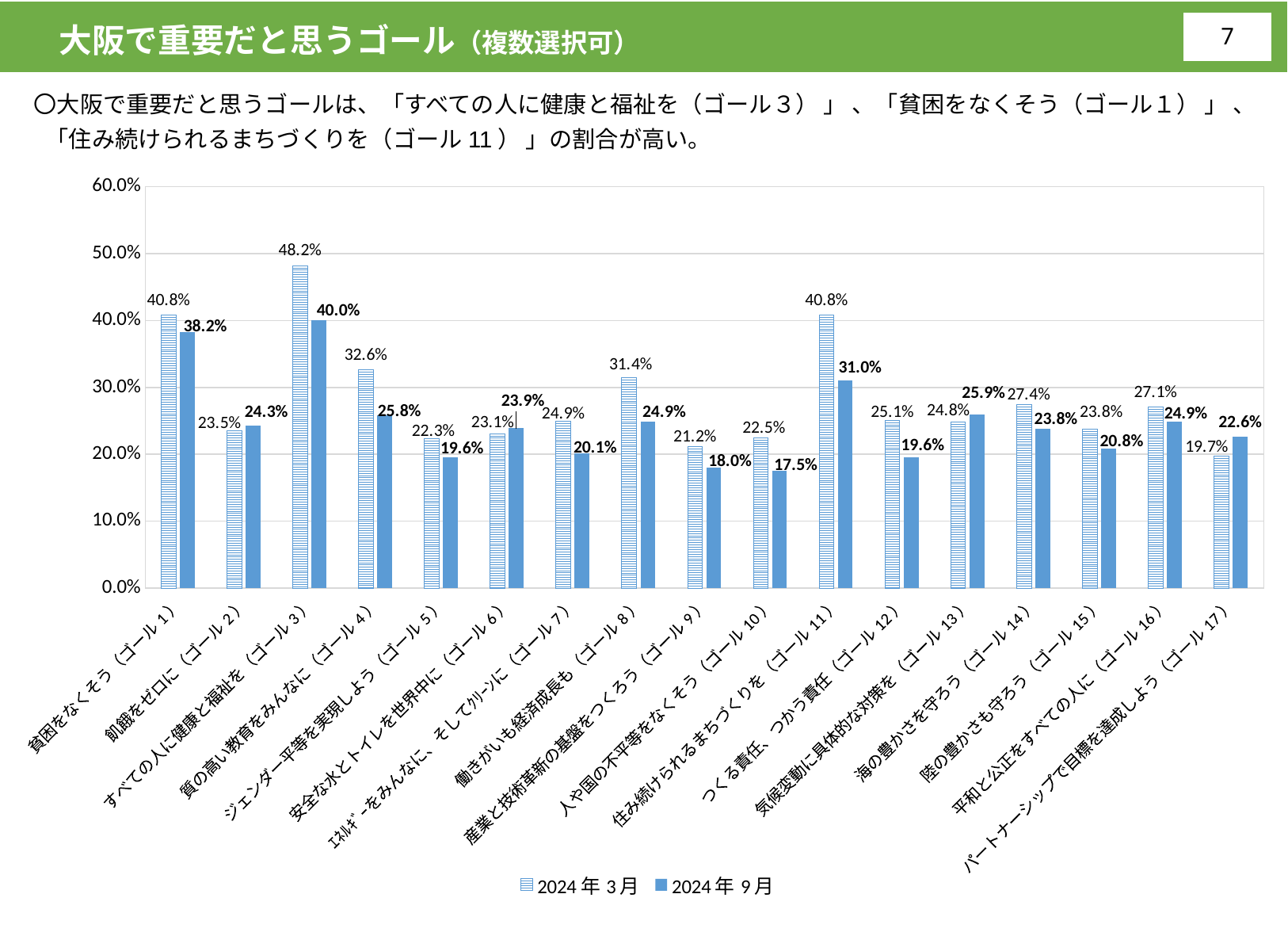
What are the two series named in the legend? 2024年3月 and 2024年9月 How many series does the legend list? 2 What is the 2024年9月 value for 人や国の不平等をなくそう（ゴール10）? 17.5% For パートナーシップで目標を達成しよう（ゴール17）, which is larger: the 2024年3月 value or the 2024年9月 value? 2024年9月 What is the difference between the 2024年3月 and 2024年9月 values for 質の高い教育をみんなに（ゴール4）? 6.8% Is the 2024年3月 value for 貧困をなくそう（ゴール1）greater or less than 40.0%? greater What kind of chart is shown on the slide? Bar chart Which category has the highest 2024年3月 value? すべての人に健康と福祉を（ゴール3） Which category has the lowest 2024年9月 value? 人や国の不平等をなくそう（ゴール10） How many categories (goals) are shown on the x axis? 17 What is the 2024年3月 value for すべての人に健康と福祉を（ゴール3）? 48.2% What is the 2024年9月 value for 住み続けられるまちづくりを（ゴール11）? 31.0%